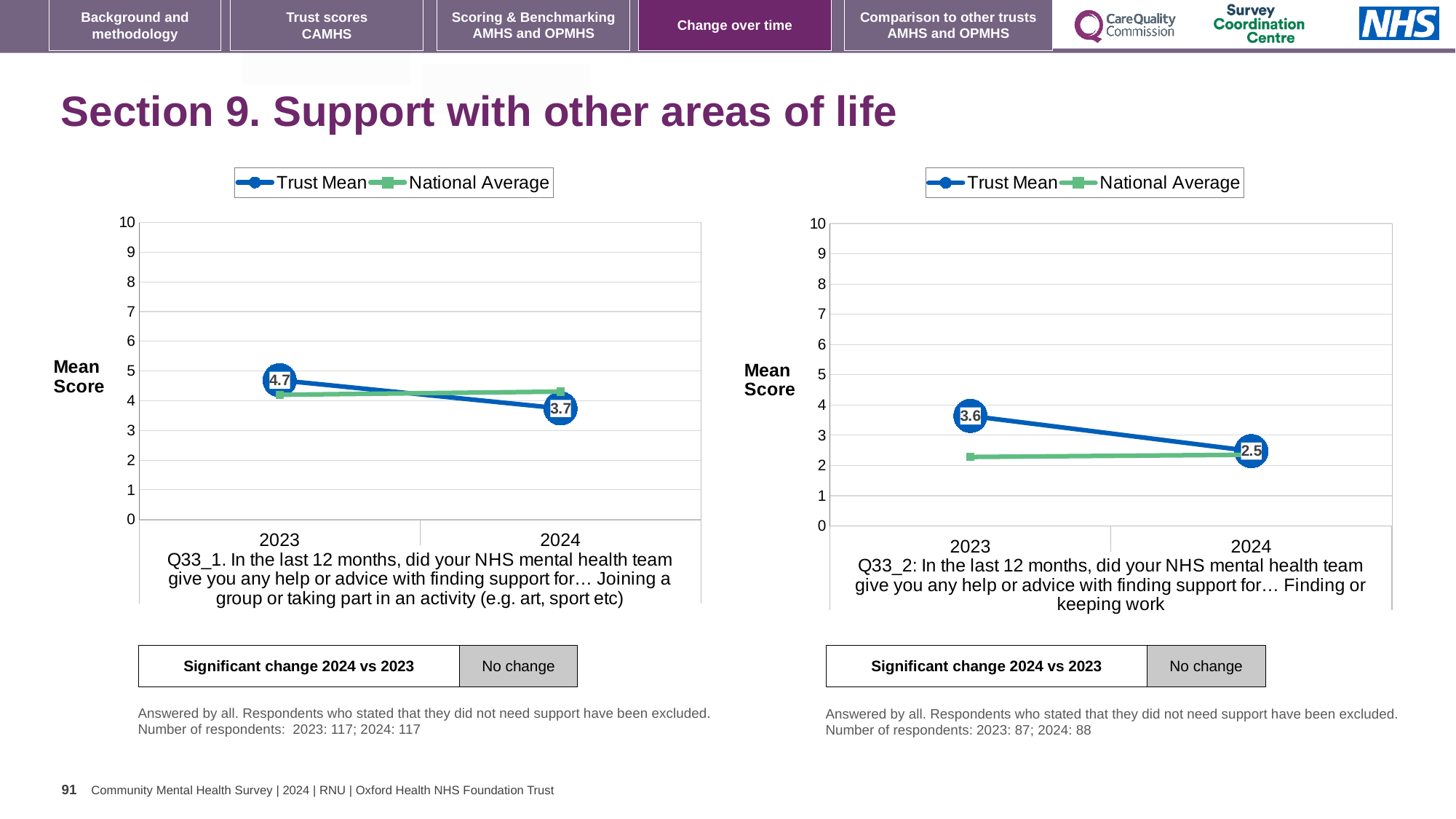
In the right chart (Q33_2), what is the Trust Mean for 2023? 3.6 How many series does the legend of the right chart (Q33_2) list? 2 In the left chart (Q33_1), what is the Trust Mean for 2024? 3.7 In the right chart (Q33_2), what is the Trust Mean for 2024? 2.5 In the right chart (Q33_2), does the Trust Mean rise or fall from 2023 to 2024? fall In the left chart (Q33_1), which is larger in 2023, the Trust Mean or the National Average? Trust Mean What kind of chart is the left chart (Q33_1)? line chart In the left chart (Q33_1), what is the Trust Mean for 2023? 4.7 In the right chart (Q33_2), is the National Average for 2023 greater or less than 3? less How many years are shown on the x axis of the left chart (Q33_1)? 2 In the left chart (Q33_1), by how much did the Trust Mean fall from 2023 to 2024? 1.0 In the right chart (Q33_2), what is the difference between the Trust Mean in 2023 and 2024? 1.1